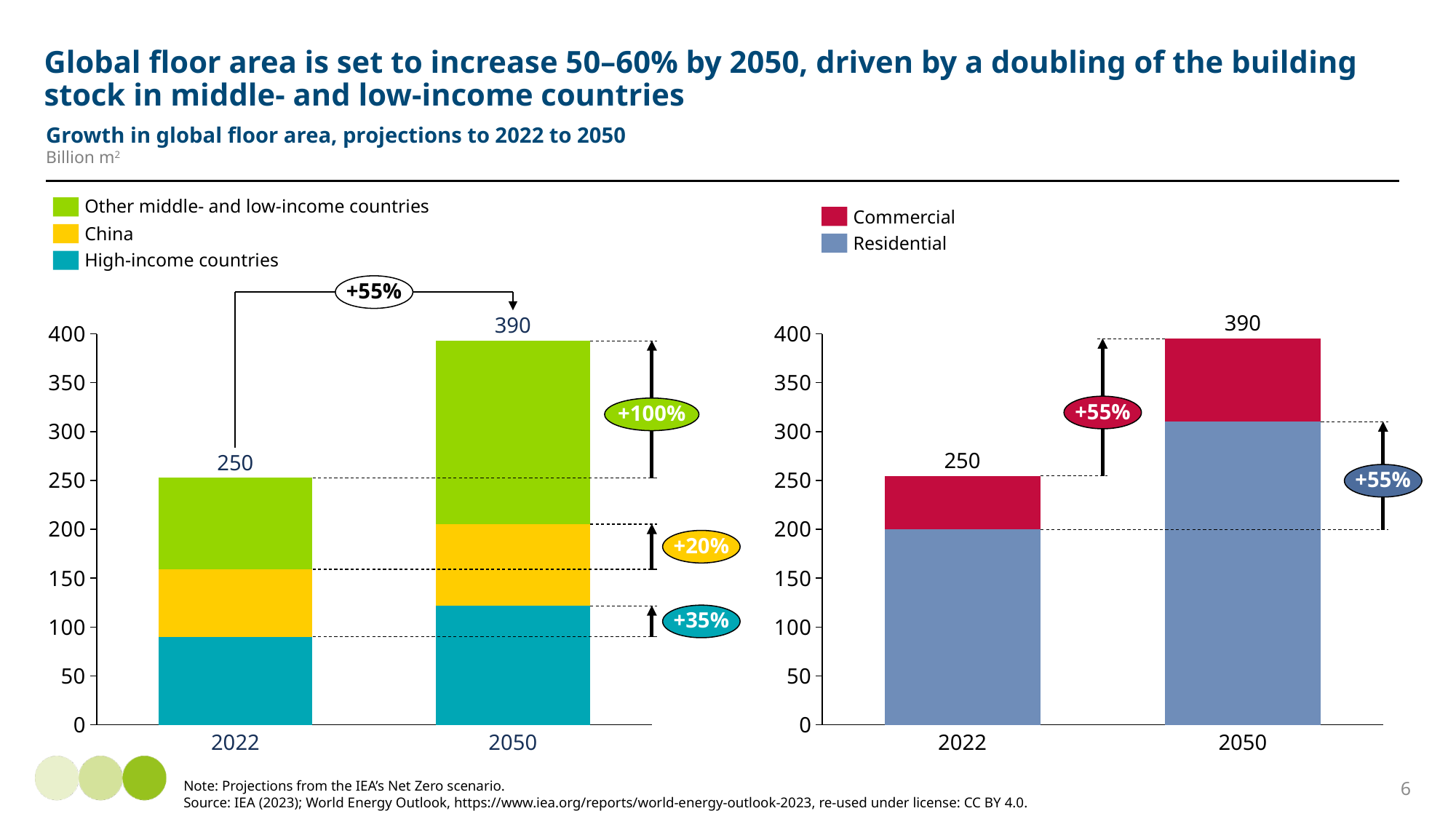
In the left chart, what percentage growth is labelled for China between 2022 and 2050? +20% What kind of chart is the right chart? Stacked bar chart In the left chart, what is the total global floor area shown for 2050? 390 In the right chart, is the Commercial value for 2022 greater or less than 100? less In the left chart, what percentage growth is labelled for Other middle- and low-income countries between 2022 and 2050? +100% In the right chart, by how much does the total floor area increase from 2022 to 2050? 140 How many series does the legend of the right chart list? 2 In the right chart, is the Residential value for 2050 greater or less than 300? greater How many series does the legend of the left chart list? 3 In the left chart, which year has the higher total floor area, 2022 or 2050? 2050 In the left chart, is the High-income countries value for 2022 greater or less than 100? less In the left chart, what is the total global floor area shown for 2022? 250